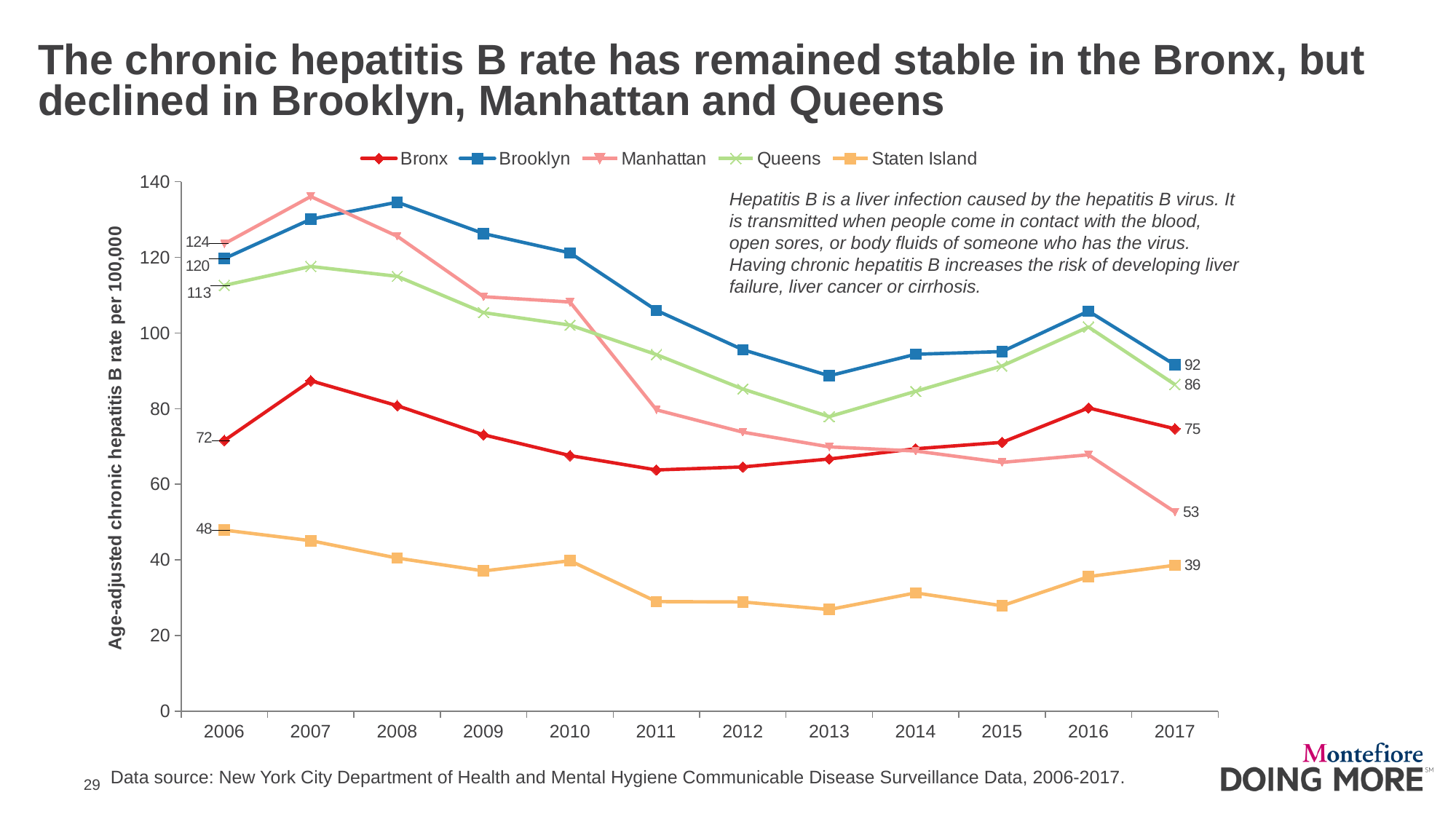
By how much did Manhattan's chronic hepatitis B rate fall from 2006 to 2017? 71 What was the chronic hepatitis B rate for Manhattan in 2006? 124 What was the chronic hepatitis B rate for Queens in 2006? 113 What was the chronic hepatitis B rate for Staten Island in 2017? 39 Was the Bronx rate higher in 2006 or in 2017? 2017 Which borough had the highest chronic hepatitis B rate in 2017? Brooklyn Is the value for Staten Island in 2013 greater or less than 40? less How many series does the legend list? 5 How many years are shown on the x axis? 12 What is the difference between Brooklyn's rate in 2006 and in 2017? 28 Is the value for Brooklyn in 2008 greater or less than 120? greater Which borough had the lowest chronic hepatitis B rate in 2006? Staten Island